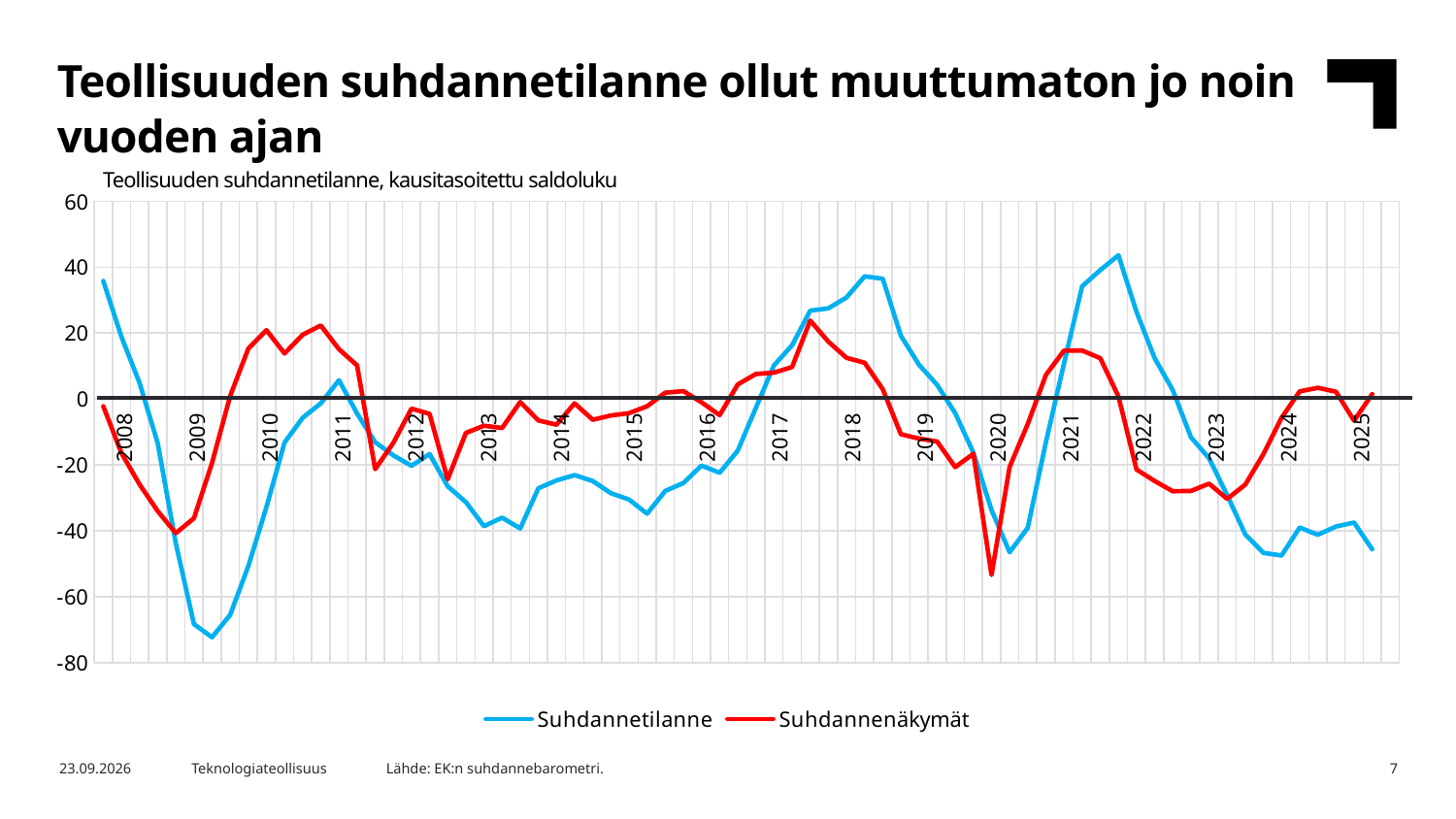
Is the value of Suhdannetilanne at the end of the series in 2025 greater or less than -40? less How many series does the legend list? 2 What is the subtitle printed above the chart? Teollisuuden suhdannetilanne, kausitasoitettu saldoluku What kind of chart is shown on the slide? line chart Does Suhdannetilanne rise or fall between its 2021 peak and 2023? fall Which series reaches the lowest value anywhere on the chart? Suhdannetilanne Is the lowest value of Suhdannenäkymät around 2020 greater or less than -40? less Which series reaches the highest value anywhere on the chart? Suhdannetilanne Is the lowest value of Suhdannetilanne around 2009 greater or less than -60? less What are the two series named in the legend? Suhdannetilanne and Suhdannenäkymät How many year labels are shown on the x axis? 18